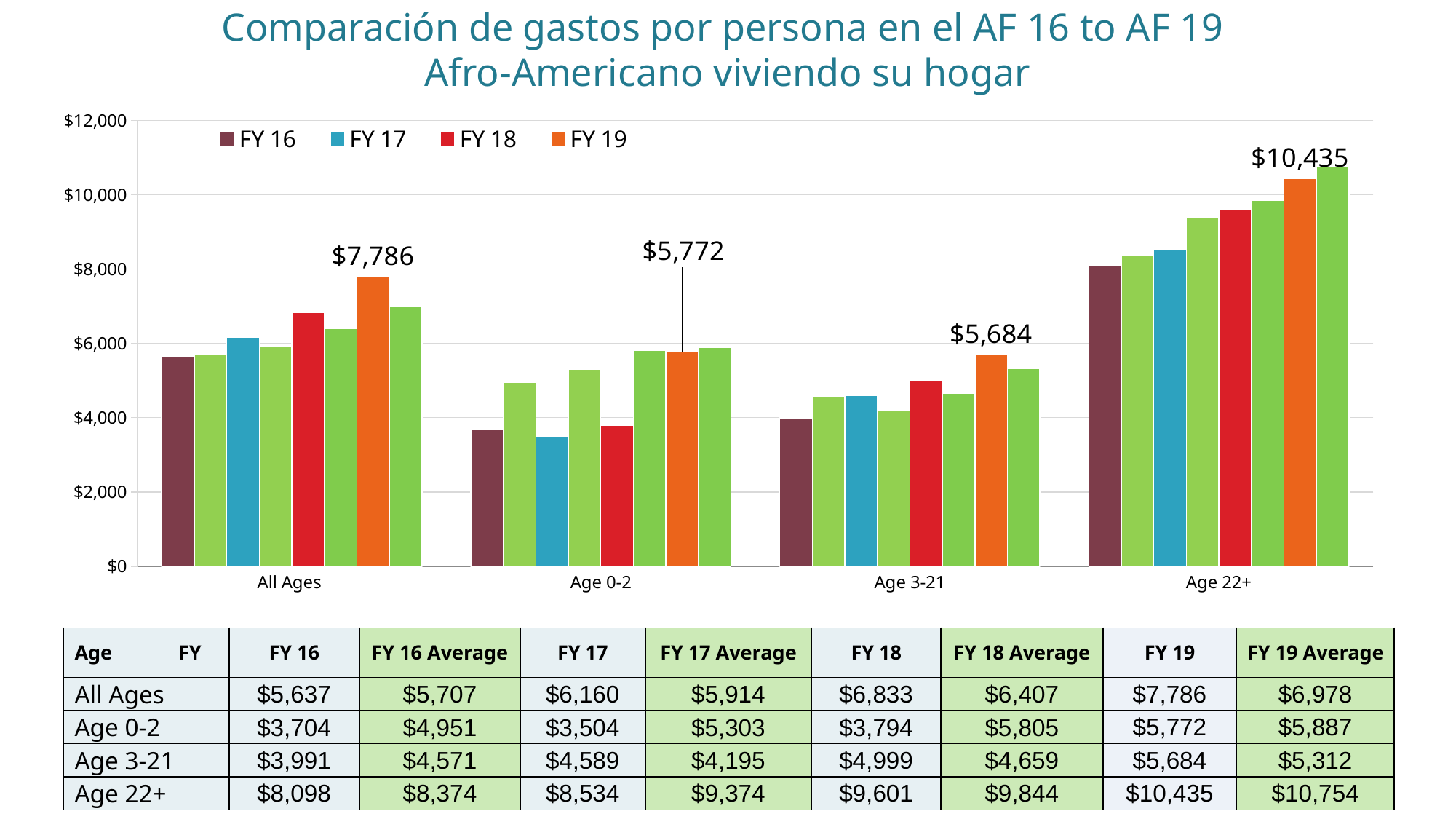
Which age category has the highest FY 19 value? Age 22+ Which age category has the lowest FY 19 value? Age 3-21 What is the FY 19 value for Age 0-2? $5,772 How many series does the chart legend list? 4 What is the FY 19 value for All Ages? $7,786 Is the FY 19 value for Age 0-2 larger or smaller than the FY 19 value for Age 3-21? larger How many age categories are shown on the x axis of the chart? 4 What is the FY 19 value for Age 22+? $10,435 Is the FY 16 value for Age 22+ greater or less than $8,000? greater What is the difference between the FY 19 values for All Ages and Age 3-21? $2,102 Do the FY 16 through FY 19 values for Age 22+ rise or fall from FY 16 to FY 19? rise What type of chart is shown on the slide? bar chart